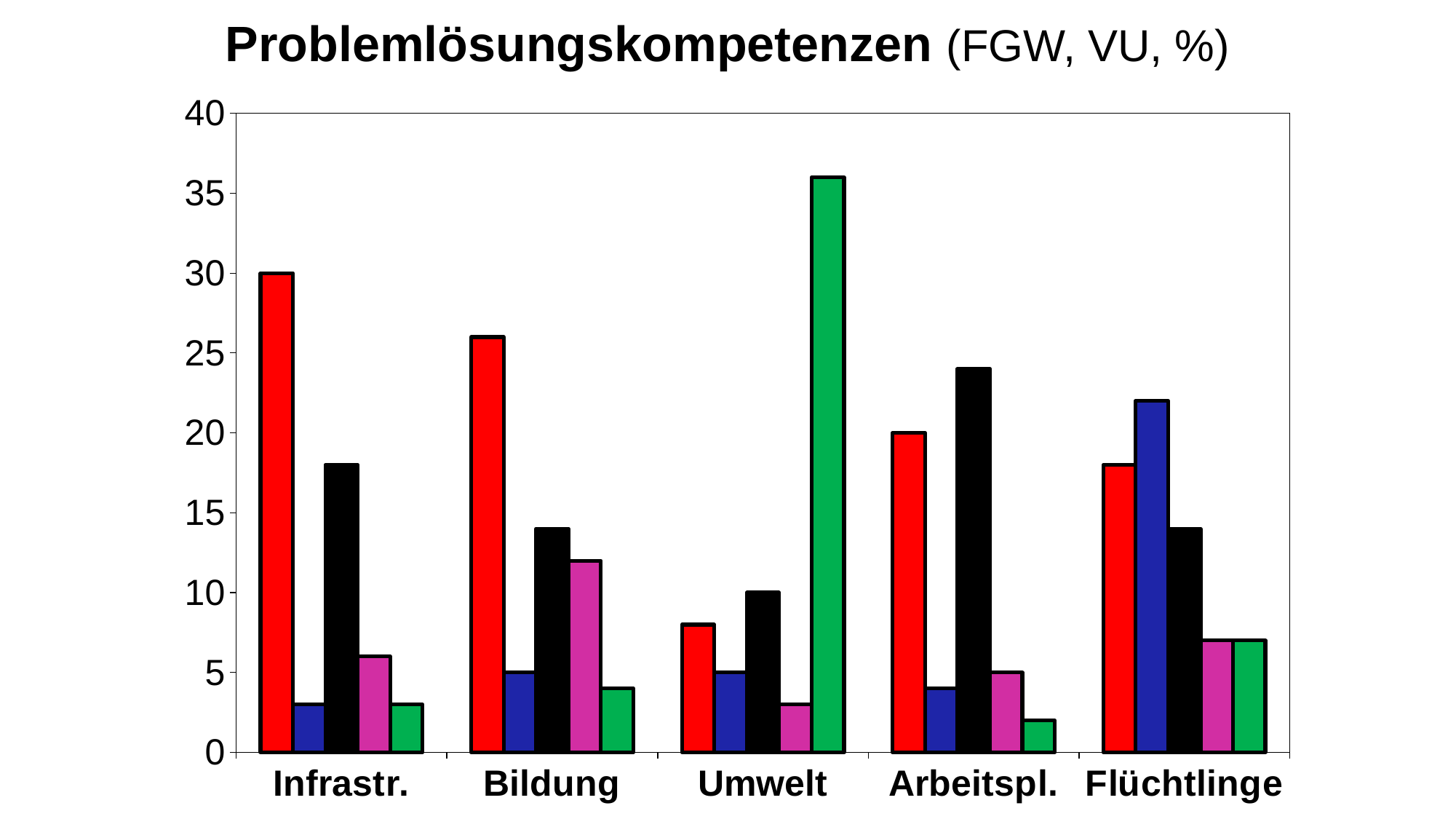
Which category has the tallest red bar? Infrastr. Which category has the tallest green bar? Umwelt What kind of chart is shown on the slide? bar chart Is the value of the green bar for Umwelt greater or less than 35? greater What is the value of the black bar for Umwelt? 10 For Flüchtlinge, which is larger: the blue bar or the black bar? blue bar How many categories are shown on the x axis? 5 What is the value of the red bar for Arbeitspl.? 20 Is the value of the red bar for Bildung greater or less than 25? greater Is the value of the black bar for Arbeitspl. greater or less than 20? greater How many bars are shown for each category? 5 What is the value of the red bar for Infrastr.? 30